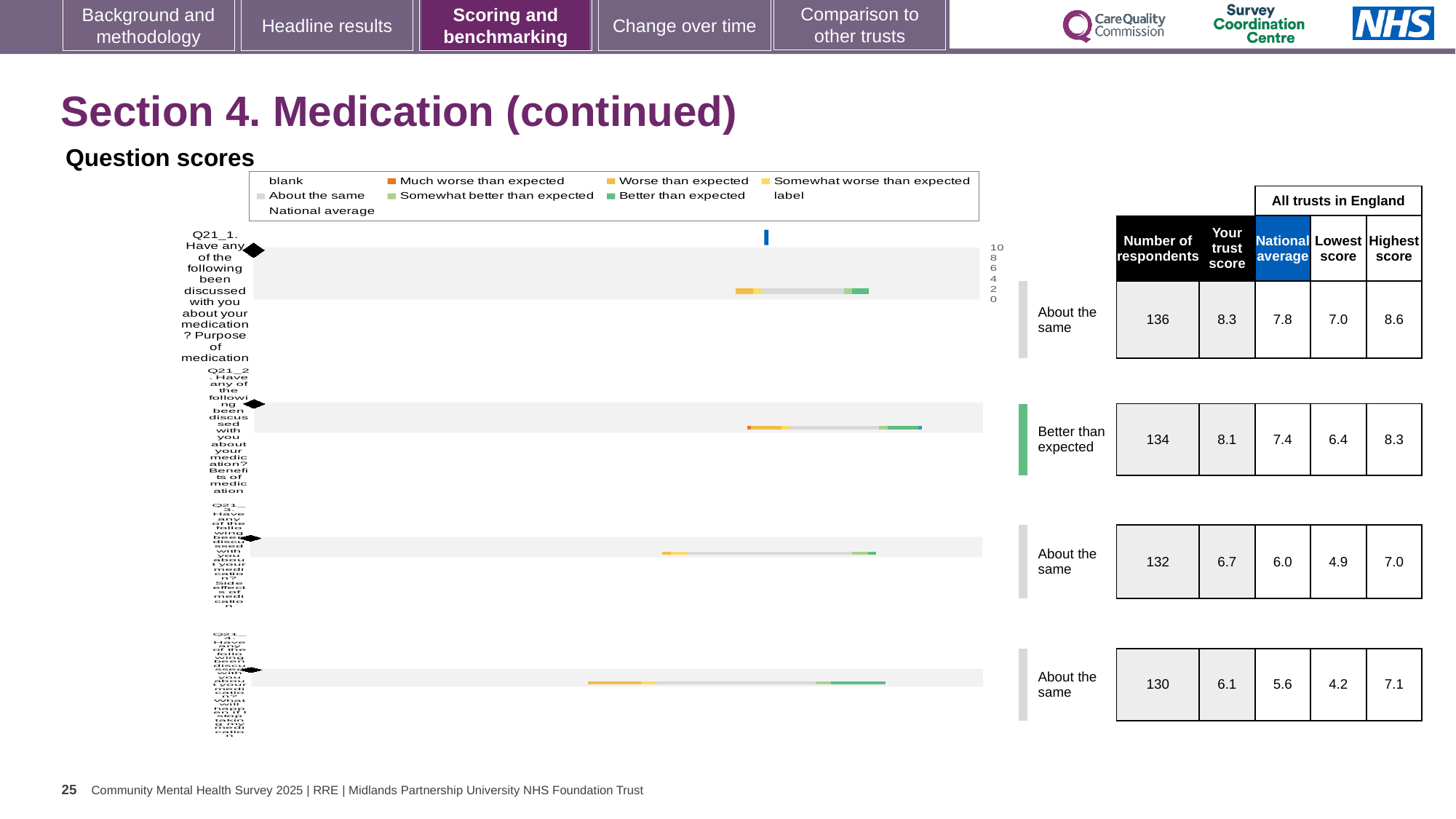
In the table beside the charts, what is the national average for Q21_2 (Benefits of medication)? 7.4 What kind of chart is used to show the question scores on this slide? bar chart Which question row has the highest trust score in the table beside the charts? Q21_1 Which question row is rated 'Better than expected' next to its bar chart? Q21_2 In the table beside the charts, what is the trust score for Q21_1 (Purpose of medication)? 8.3 How many question bar charts are shown on the slide? 4 What is the difference between the trust score and the national average for Q21_2 in the table beside the charts? 0.7 What is the highest tick value shown on the axis of the first bar chart (Q21_1)? 10 In the table beside the charts, what is the highest score for the fourth question row? 7.1 In the table beside the charts, what is the lowest score for the third question row? 4.9 Which legend entry is shown in orange in the chart legend? Much worse than expected In the table beside the charts, what is the number of respondents for Q21_1 (Purpose of medication)? 136